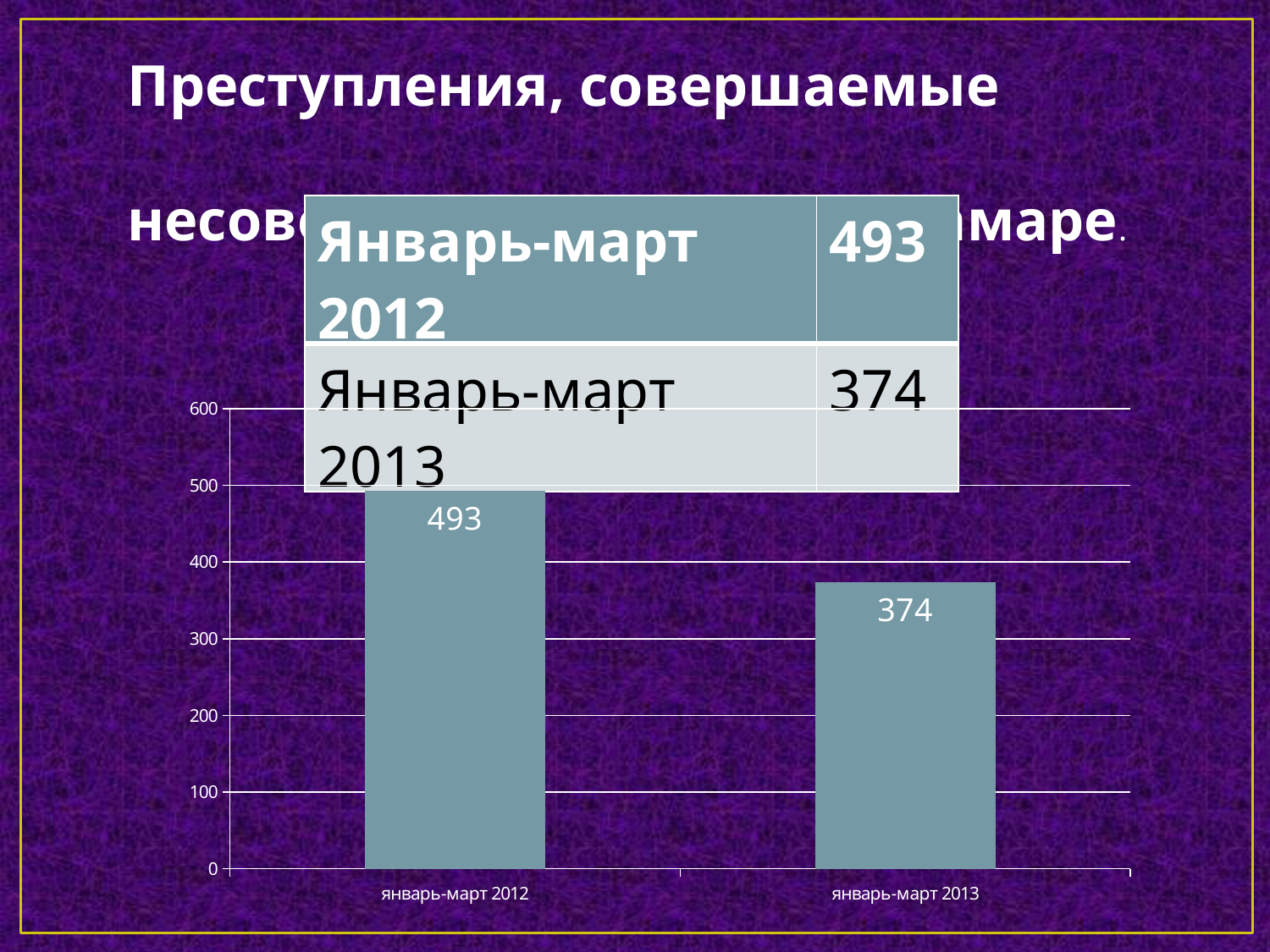
Do the values rise or fall from январь-март 2012 to январь-март 2013? fall Is the value for январь-март 2013 greater or less than 400? less Which is larger, the value for январь-март 2012 or for январь-март 2013? январь-март 2012 How many categories are shown on the x axis? 2 What is the value for январь-март 2012? 493 What is the difference between the values for январь-март 2012 and январь-март 2013? 119 Which category has the highest value? январь-март 2012 Which category has the lowest value? январь-март 2013 What is the value for январь-март 2013? 374 Is the value for январь-март 2012 greater or less than 400? greater What is the highest value shown on the vertical axis? 600 What kind of chart is shown on the slide? bar chart